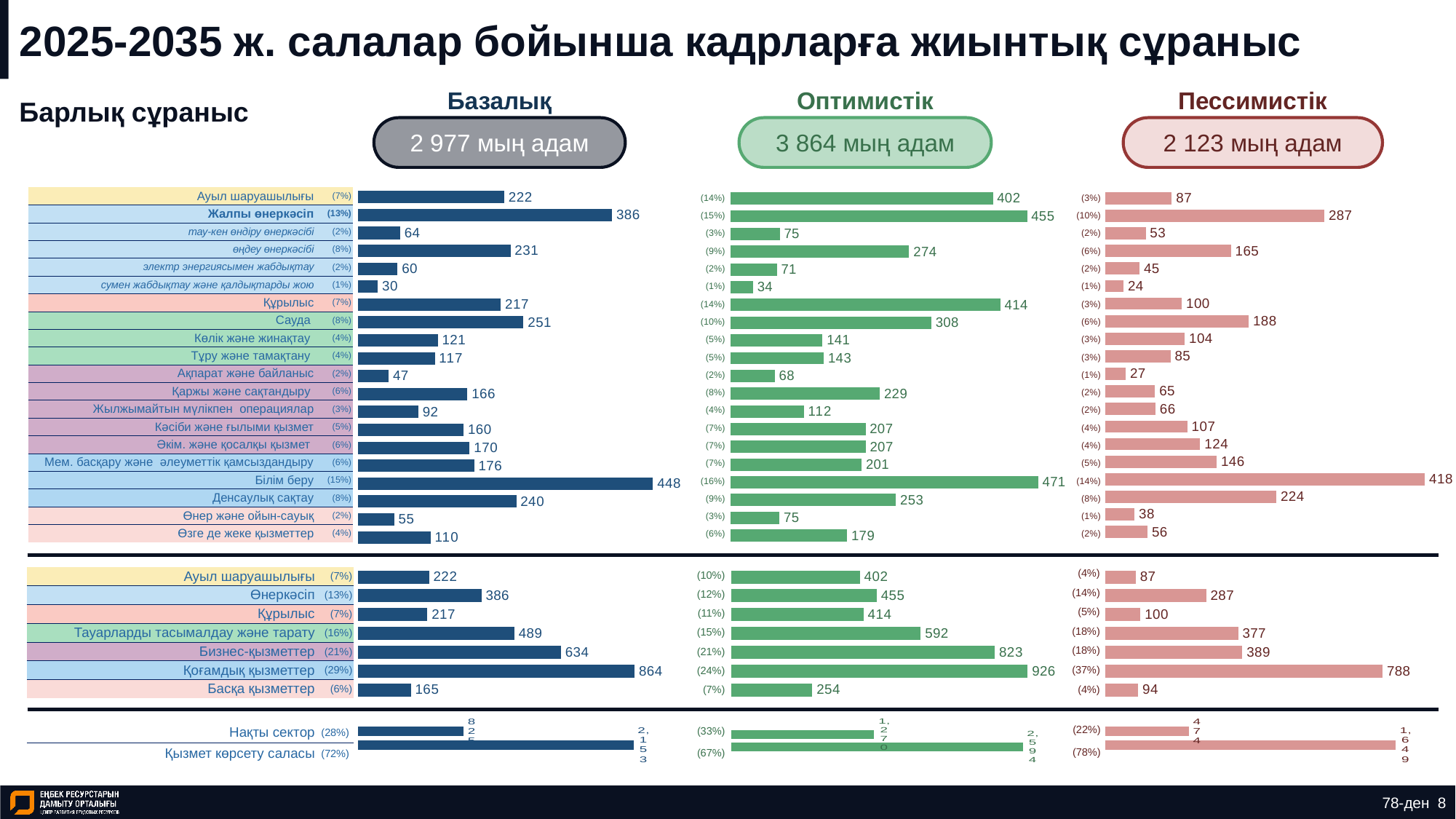
What total is shown for the Оптимистік scenario? 3 864 мың адам In the Базалық chart, what is the value for Қоғамдық қызметтер in the middle section? 864 In the Пессимистік chart, what is the value for Денсаулық сақтау? 224 What kind of chart is used on this slide? Bar chart In the Базалық chart, what is the difference between Жалпы өнеркәсіп and Құрылыс? 169 In the Оптимистік chart, what is the value for Сауда? 308 In the Пессимистік chart, which is larger: Сауда or өңдеу өнеркәсібі? Сауда In the Оптимистік chart, what is the difference between Бизнес-қызметтер and Тауарларды тасымалдау және тарату? 231 In the Оптимистік chart, which category in the upper section has the highest value? Білім беру How many categories are shown in the middle section of the charts (from Ауыл шаруашылығы to Басқа қызметтер)? 7 In the Базалық chart, what is the value for Білім беру? 448 In the Базалық chart, which category in the upper section has the lowest value? сумен жабдықтау және қалдықтарды жою